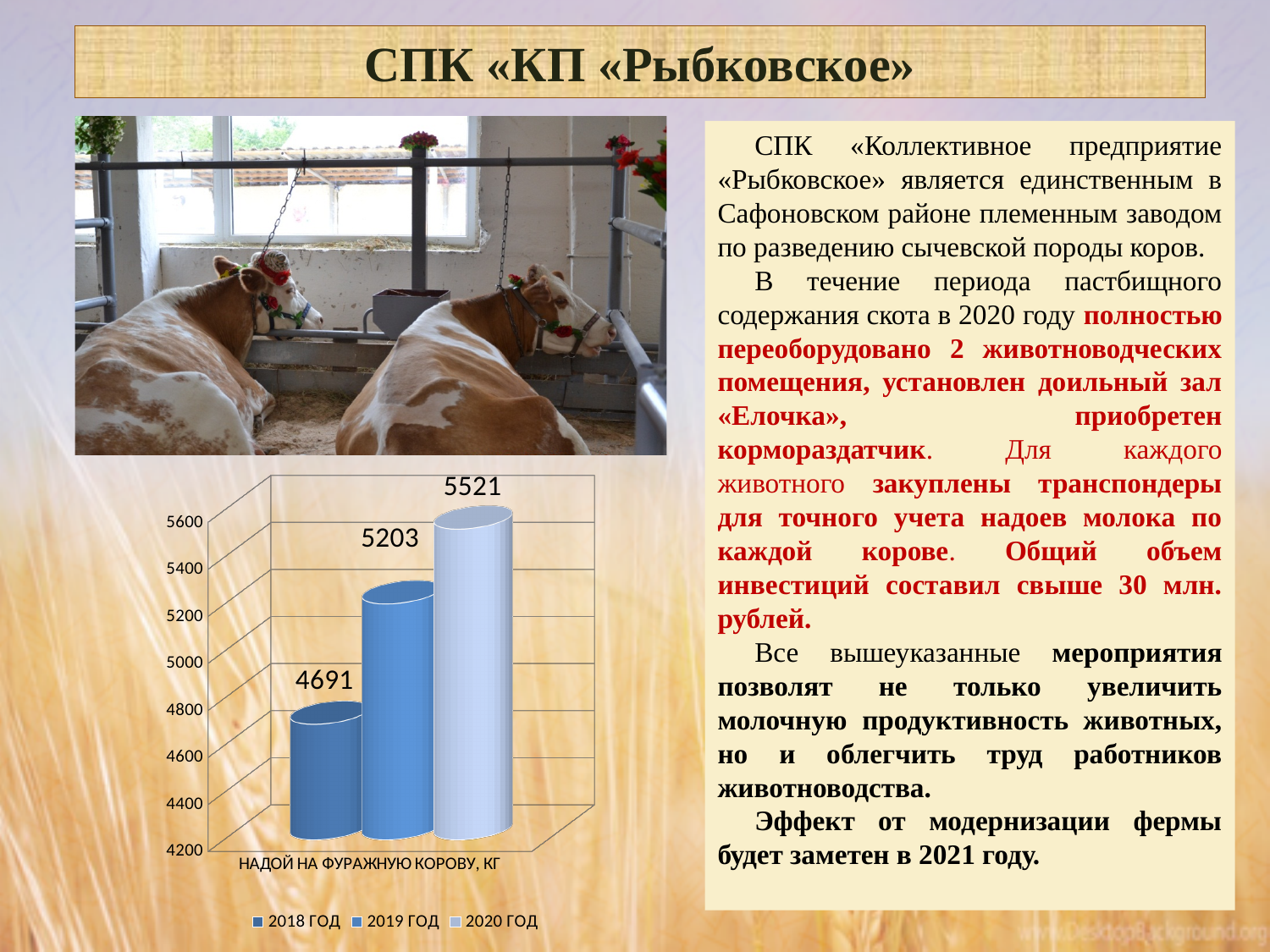
What is the difference in milk yield per forage cow between 2020 ГОД and 2018 ГОД? 830 How many series does the chart legend list? 3 Is the value for 2018 ГОД greater or less than 5000? less By how much did the milk yield per forage cow increase from 2019 ГОД to 2020 ГОД? 318 What kind of chart is shown on the slide? bar chart What is the milk yield per forage cow for 2019 ГОД? 5203 Which is larger, the milk yield for 2018 ГОД or for 2019 ГОД? 2019 ГОД Which year has the highest milk yield per forage cow? 2020 ГОД Which year has the lowest milk yield per forage cow? 2018 ГОД What is the milk yield per forage cow for 2018 ГОД? 4691 What is the milk yield per forage cow for 2020 ГОД? 5521 Do the milk yield values rise or fall from 2018 ГОД to 2020 ГОД? rise